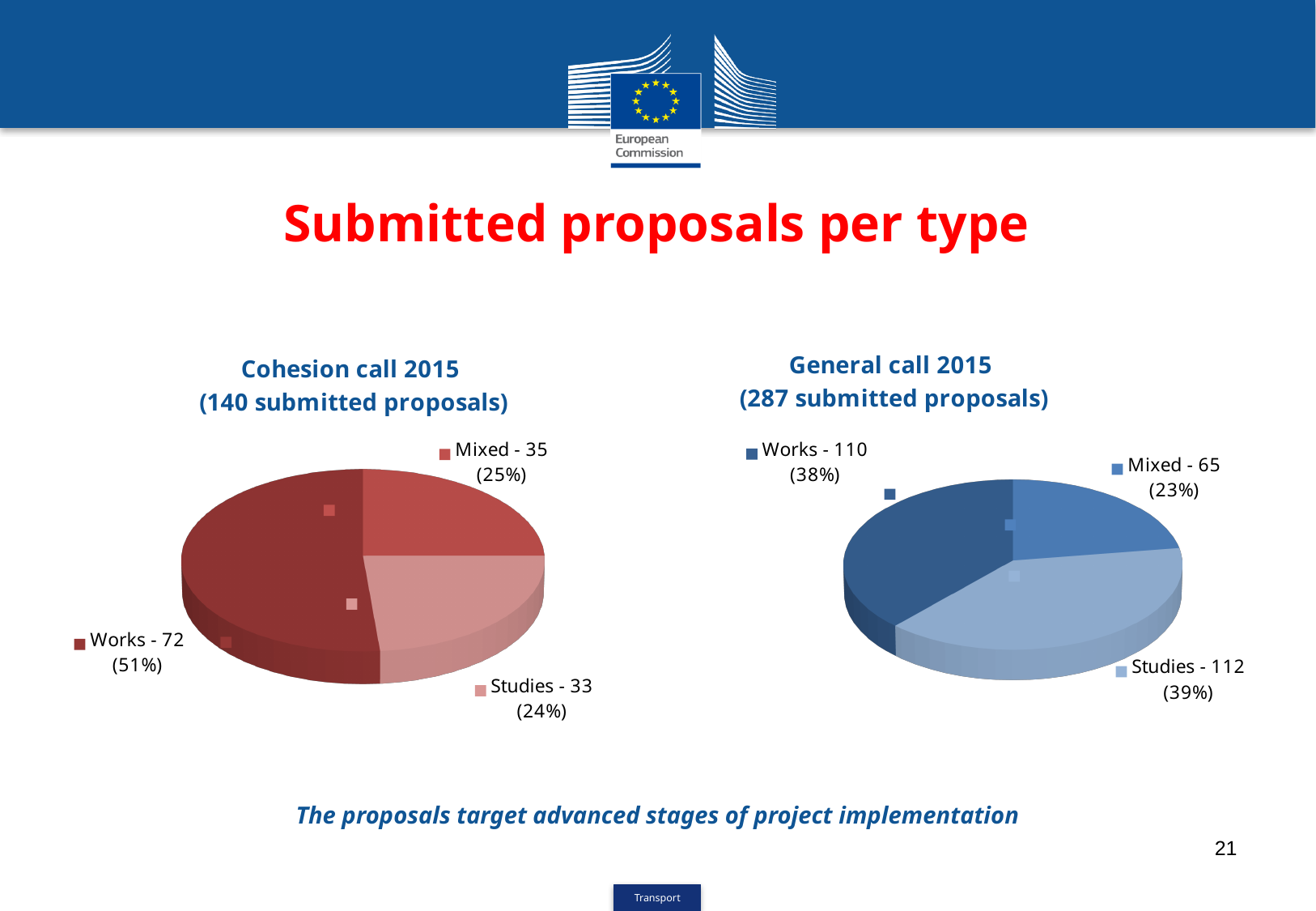
How many slices does the General call 2015 chart have? 3 In the General call 2015 chart, how many proposals are Studies? 112 In the General call 2015 chart, which type has the fewest proposals? Mixed How many submitted proposals does the General call 2015 chart title state? 287 In the Cohesion call 2015 chart, which is larger, Mixed or Studies? Mixed In the General call 2015 chart, what share of proposals is Works? 38% What kind of chart is the Cohesion call 2015 chart? Pie chart In the General call 2015 chart, what is the difference between Studies and Mixed proposals? 47 In the Cohesion call 2015 chart, which type has the most proposals? Works In the Cohesion call 2015 chart, what is the difference between Works and Studies proposals? 39 In the Cohesion call 2015 chart, what share of proposals is Mixed? 25% In the Cohesion call 2015 chart, how many proposals are Works? 72